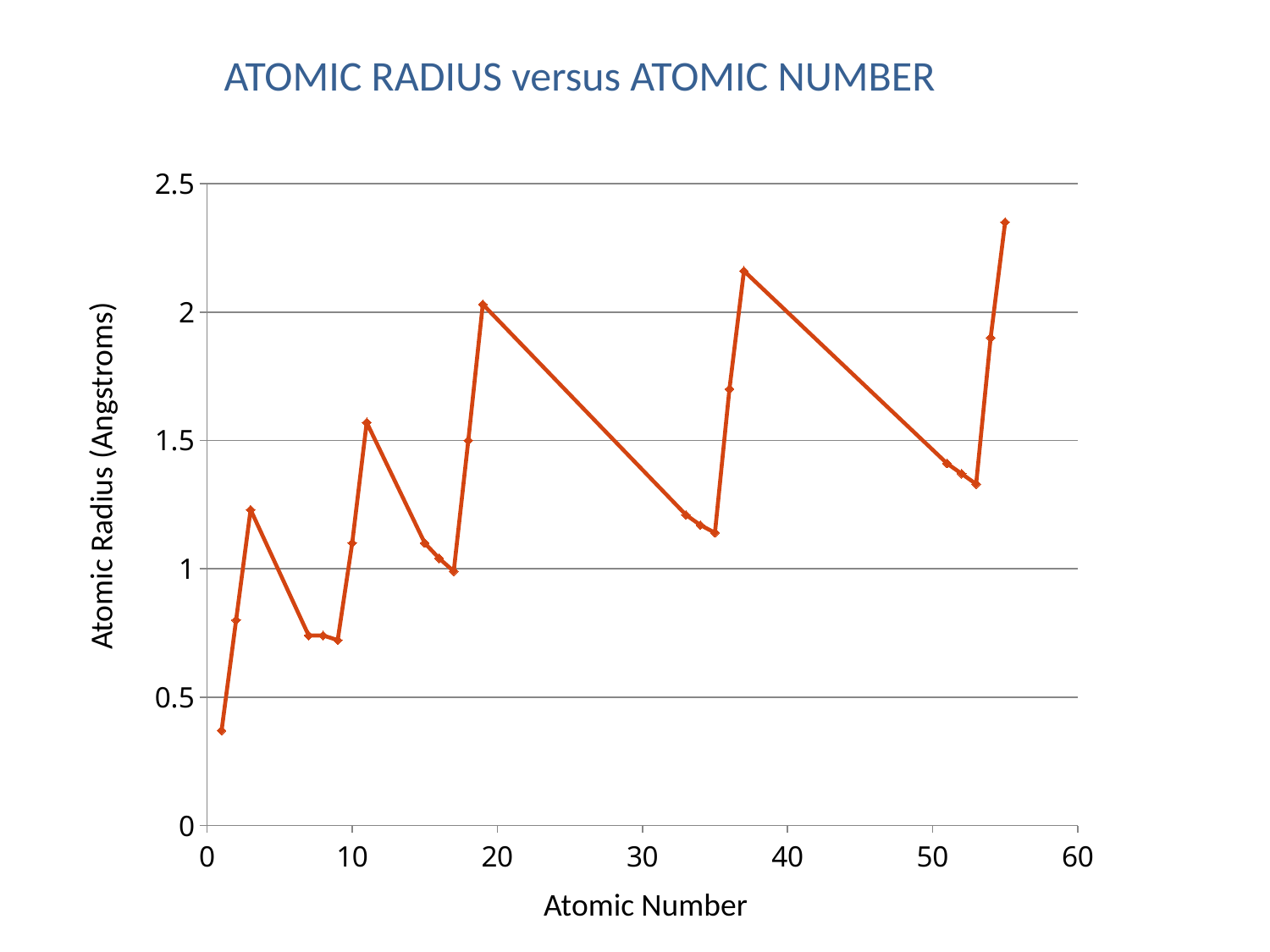
Is the atomic radius at atomic number 11 greater or less than 1.5? greater At which atomic number is the atomic radius highest? 55 Do the peaks of the atomic radius generally rise or fall as atomic number increases? rise Is the atomic radius at atomic number 9 greater or less than 1? less Is the atomic radius at atomic number 37 greater or less than 2? greater Which has the larger atomic radius, atomic number 37 or atomic number 19? 37 Which has the larger atomic radius, atomic number 3 or atomic number 11? 11 What is the label of the vertical axis? Atomic Radius (Angstroms) What is the title of the chart? ATOMIC RADIUS versus ATOMIC NUMBER At which atomic number is the atomic radius lowest? 1 What kind of chart is shown on the slide? line chart